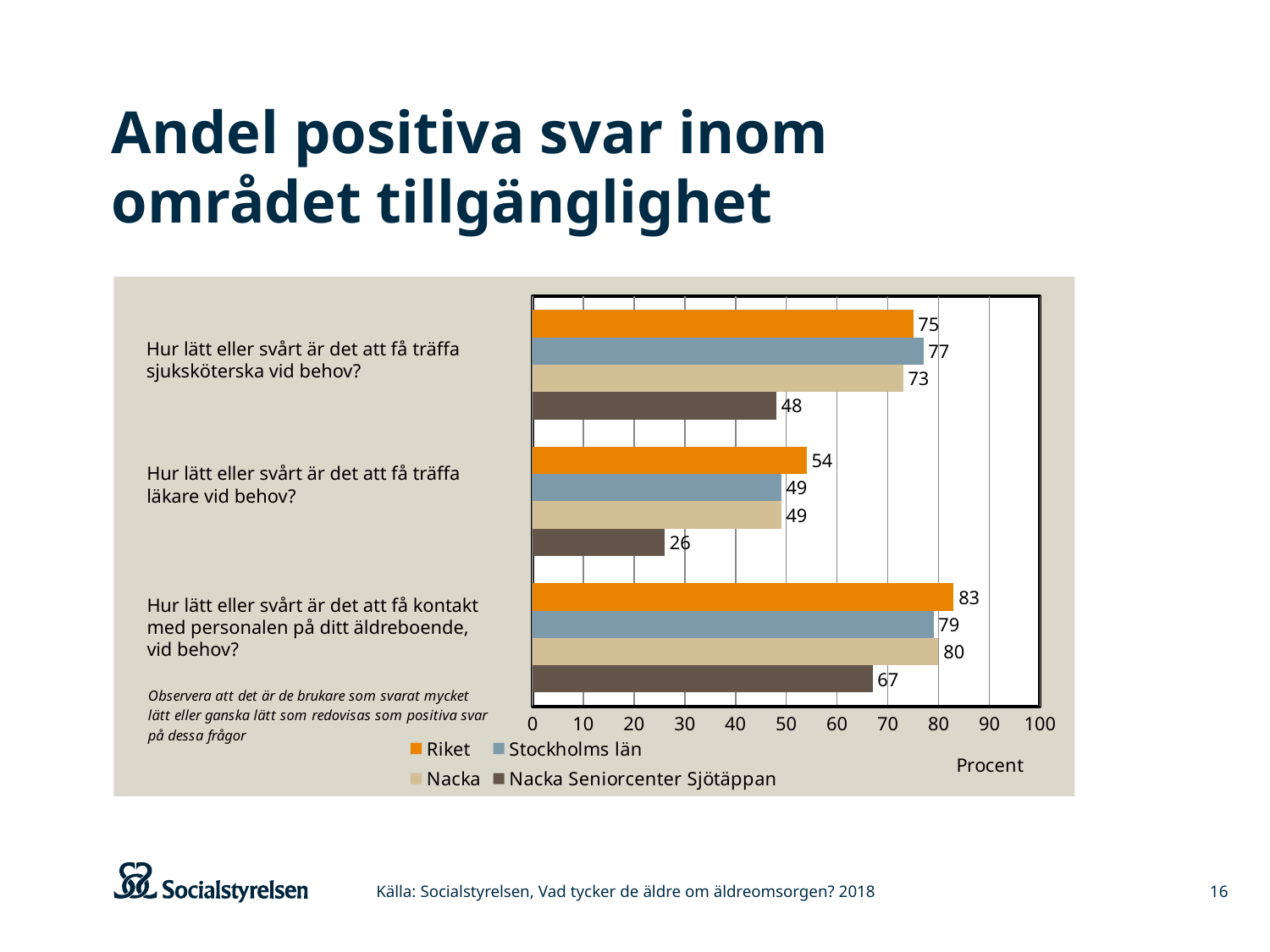
How many series does the legend list? 4 What is the difference between Stockholms län and Nacka Seniorcenter Sjötäppan on the question about meeting a nurse when needed? 29 What label is shown on the horizontal axis of the chart? Procent Which series has the highest value on the question about getting in contact with staff at the care home? Riket What is the difference between Riket and Nacka Seniorcenter Sjötäppan on the question about getting in contact with staff at the care home? 16 What is the value for Nacka Seniorcenter Sjötäppan on the question about meeting a nurse (sjuksköterska) when needed? 48 What is the value for Nacka on the question about getting in contact with staff at the care home (äldreboende)? 80 How many question categories are plotted in the chart? 3 What is the value for Riket on the question about meeting a doctor (läkare) when needed? 54 Which series has the lowest value on the question about meeting a doctor (läkare) when needed? Nacka Seniorcenter Sjötäppan What kind of chart is shown on the slide? Bar chart Which is larger on the question about meeting a nurse: the value for Stockholms län or the value for Nacka? Stockholms län